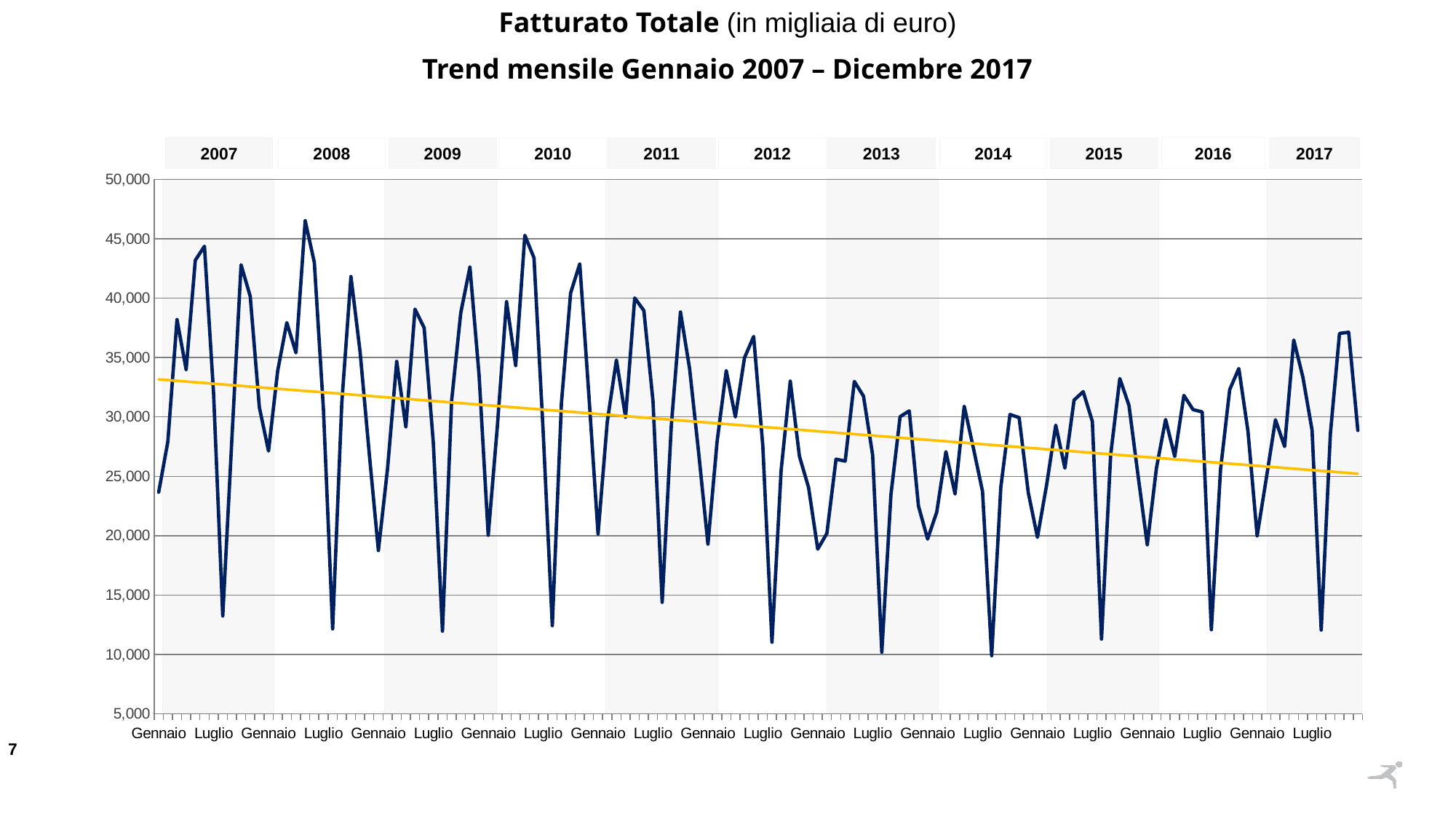
Is the yellow trend line at the start of 2007 greater or less than 30,000? greater In what unit is the revenue expressed according to the chart title? migliaia di euro Does the yellow trend line rise or fall from January 2007 to December 2017? fall Is the highest peak in 2008 greater or less than 45,000? greater In which year does the monthly revenue reach its highest peak? 2008 Is the lowest point in 2014 greater or less than 15,000? less Which year has the higher peak monthly value, 2008 or 2017? 2008 How many years are labelled along the top of the chart? 11 What kind of chart is shown on the slide? line chart What is the highest value shown on the vertical axis? 50,000